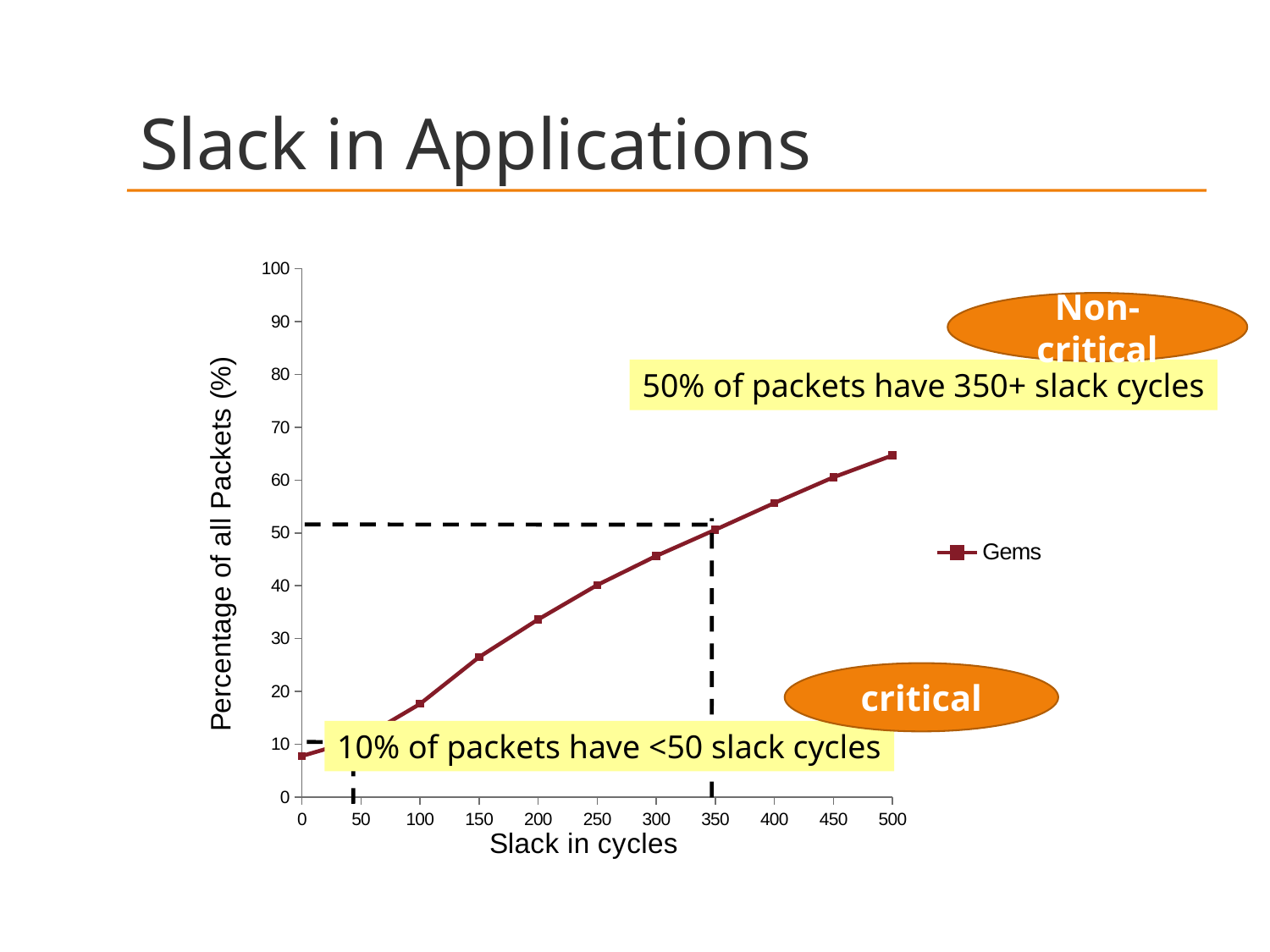
What kind of chart is shown on the slide? line chart Which is larger for Gems: the value at 400 slack cycles or the value at 250 slack cycles? 400 slack cycles Is the value for Gems at 200 slack cycles greater or less than 30? greater Is the value for Gems at 150 slack cycles greater or less than 30? less Do the values of the Gems series rise or fall as slack in cycles increases? rise At which slack value is the Gems series lowest? 0 What is the name of the series shown in the legend? Gems At which slack value is the Gems series highest? 500 Is the value for Gems at 300 slack cycles greater or less than 50? less What is the title of the x axis? Slack in cycles How many series does the legend list? 1